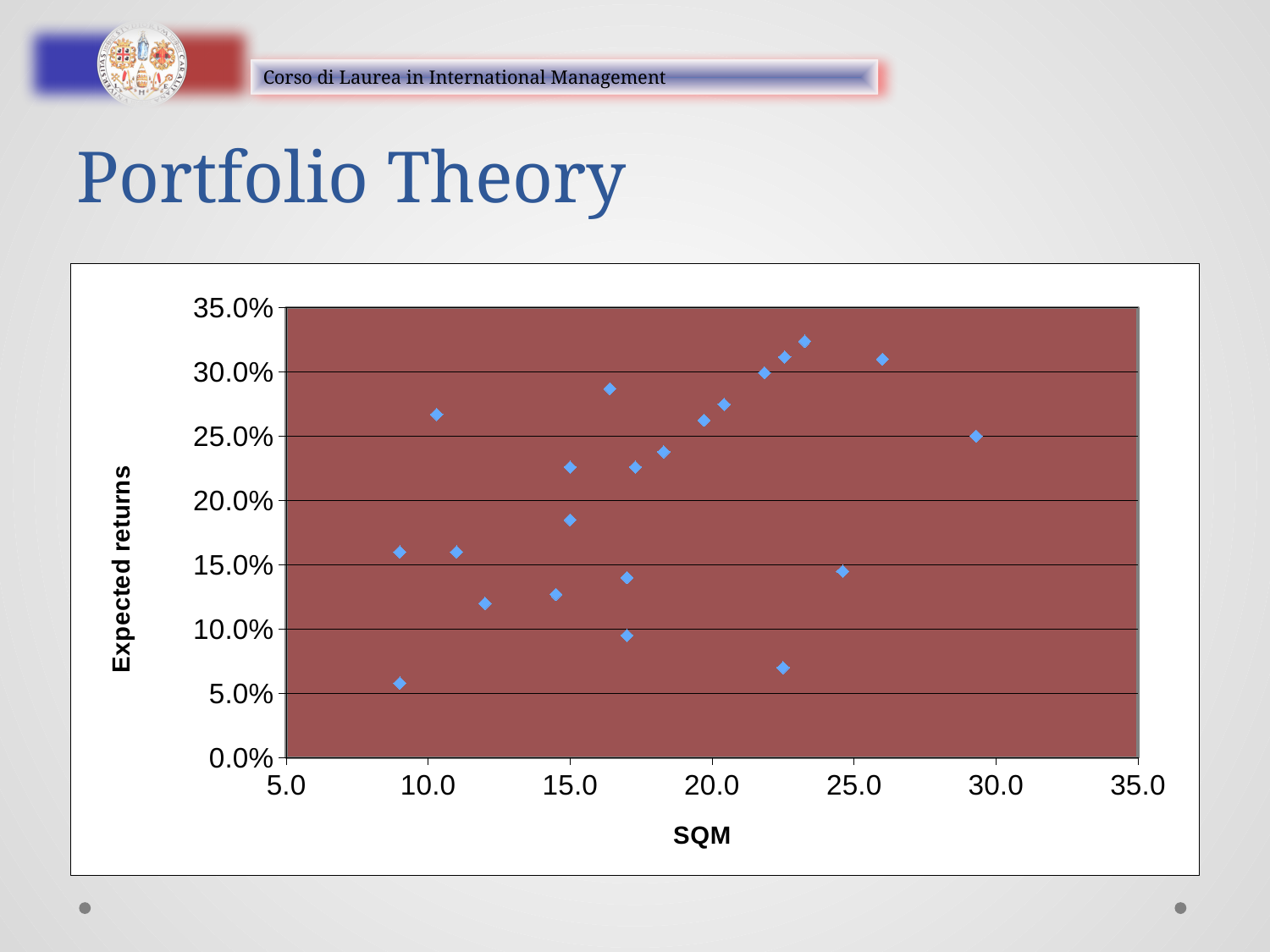
Is the expected return of the lowest point on the chart greater or less than 10.0%? less What is the title of the horizontal axis of the chart? SQM Overall, do expected returns tend to rise or fall as SQM increases along the x axis? rise Is the SQM of the point with the lowest expected return greater or less than 10.0? less Is the expected return of the highest point on the chart greater or less than 30.0%? greater What is the lowest value shown on the horizontal axis of the chart? 5.0 What is the title of the vertical axis of the chart? Expected returns How many data points are plotted on the chart? 22 What kind of chart is shown on the slide? Scatter chart What is the highest value shown on the vertical axis of the chart? 35.0%